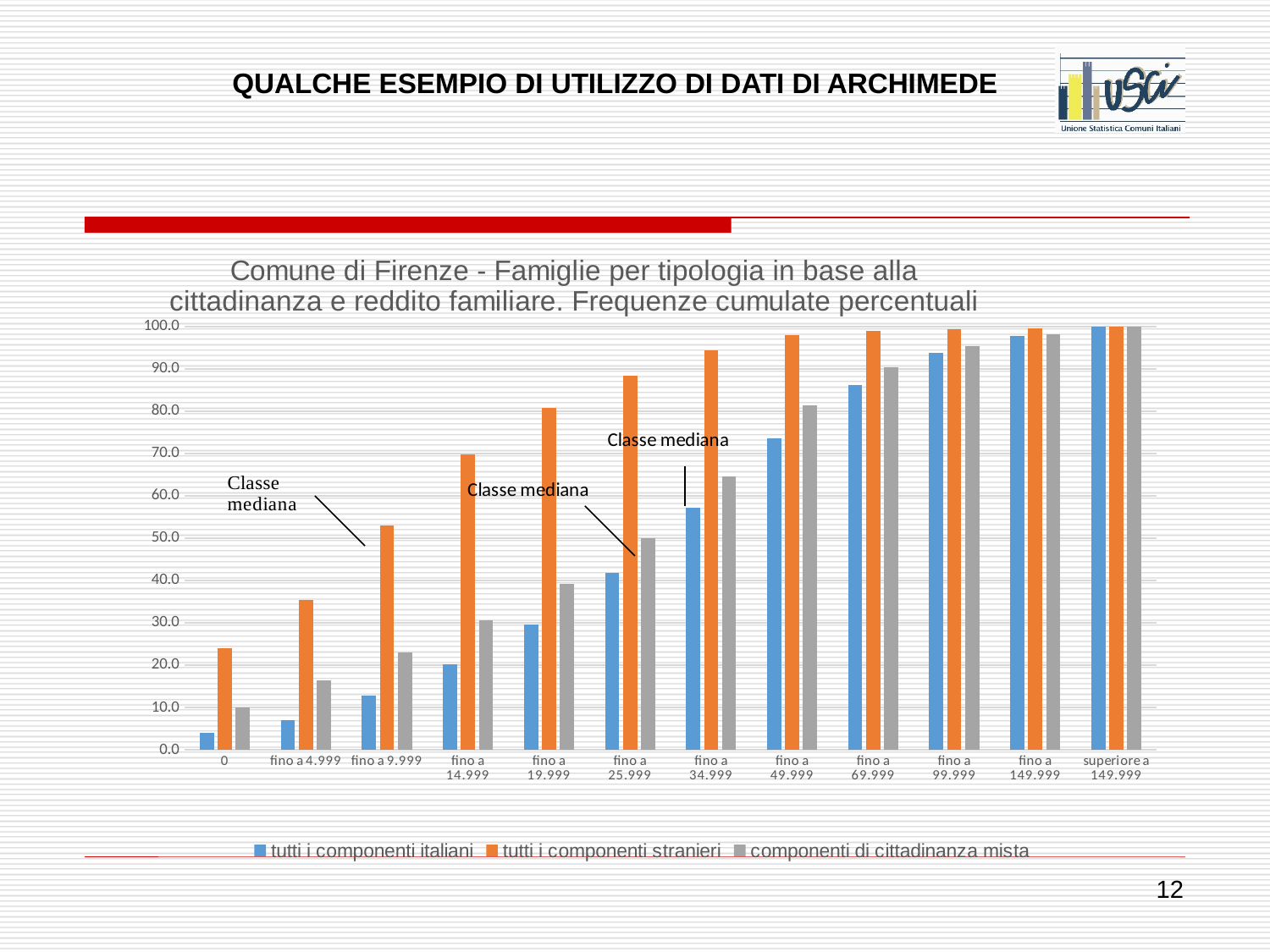
In the 'fino a 9.999' category, which is larger: 'tutti i componenti stranieri' or 'tutti i componenti italiani'? tutti i componenti stranieri How many series does the legend list? 3 In the 'fino a 25.999' category, which is larger: 'componenti di cittadinanza mista' or 'tutti i componenti italiani'? componenti di cittadinanza mista Is the value for 'tutti i componenti italiani' in the '0' category greater or less than 10.0? less What kind of chart is shown on the slide? bar chart Which series has the highest value in the 'fino a 4.999' category? tutti i componenti stranieri Is the value for 'componenti di cittadinanza mista' in the 'fino a 34.999' category greater or less than 60.0? greater Do the values for 'tutti i componenti italiani' rise or fall as you move from left to right along the x axis? rise Which series has the lowest value in the '0' category? tutti i componenti italiani How many income categories are shown along the x axis? 12 What colour are the bars for 'tutti i componenti stranieri'? orange Is the value for 'tutti i componenti stranieri' in the 'fino a 14.999' category greater or less than 60.0? greater